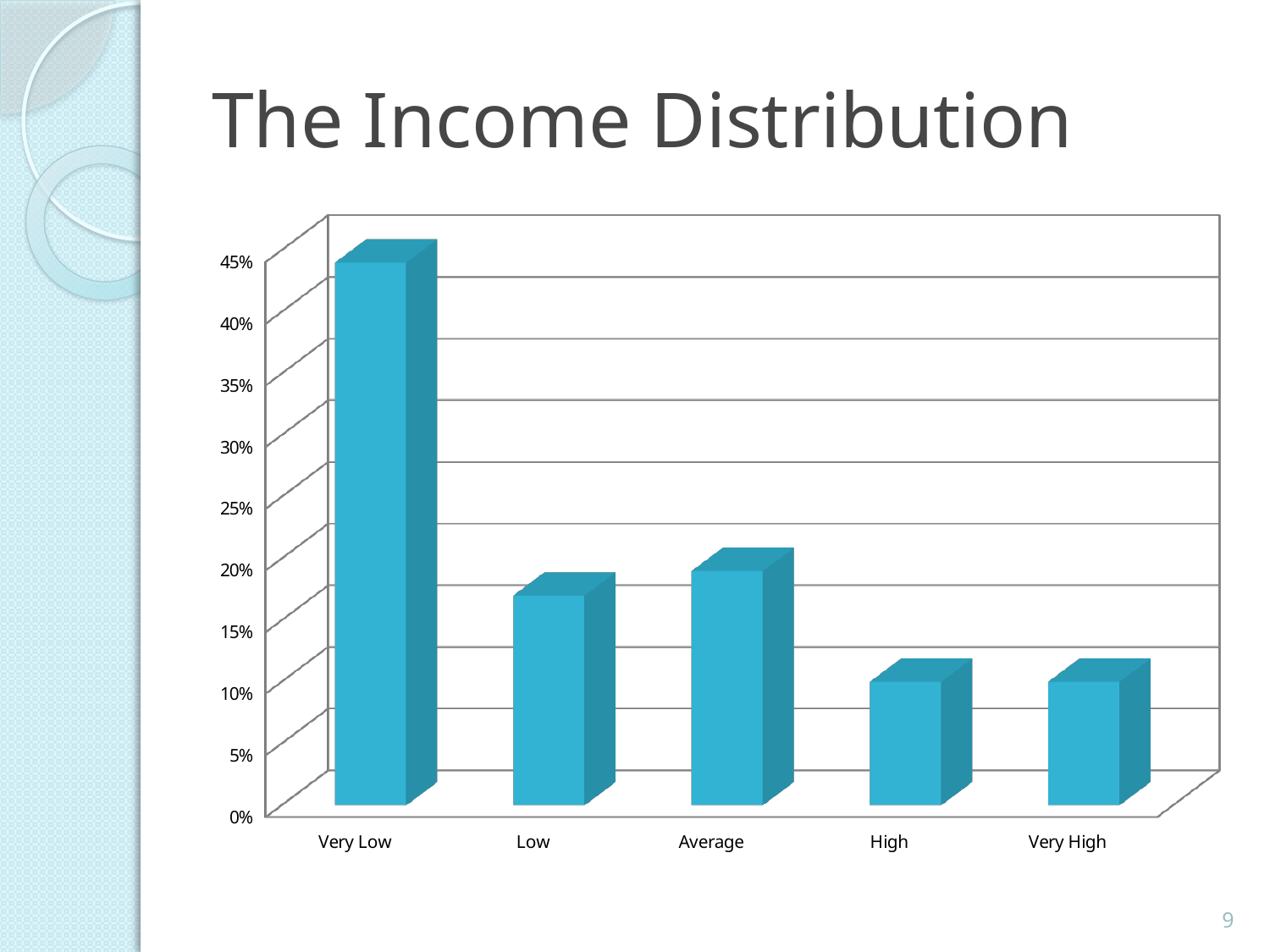
What kind of chart is shown on the slide? bar chart How many income categories are shown on the x axis? 5 Is the value for High greater or less than 15%? less What is the title of the chart? The Income Distribution Which is larger, the value for Average or the value for High? Average Which is larger, the value for Very Low or the value for Average? Very Low Which income category has the highest value? Very Low Is the value for Very High greater or less than 15%? less Is the value for Very Low greater or less than 40%? greater